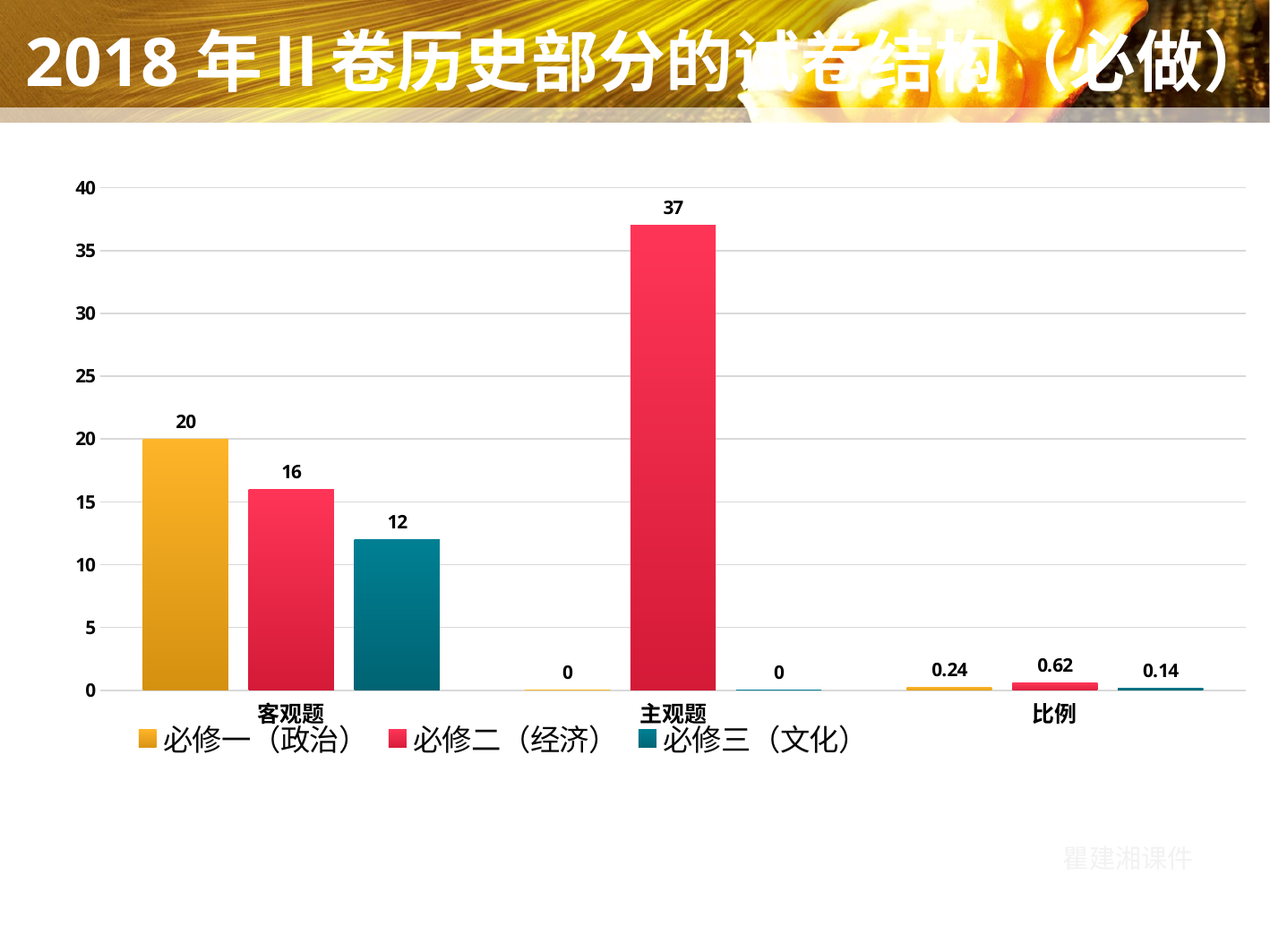
How many categories are shown on the x axis? 3 What is the value for 必修一（政治） in the 客观题 category? 20 How many series does the legend list? 3 What is the value for 必修三（文化） in the 比例 category? 0.14 What is the difference between the 必修一（政治） and 必修三（文化） values in the 客观题 category? 8 Which series has the lowest value in the 比例 category? 必修三（文化） What is the value for 必修二（经济） in the 主观题 category? 37 In the 比例 category, which is larger: 必修一（政治） or 必修二（经济）? 必修二（经济） What is the value for 必修一（政治） in the 主观题 category? 0 What kind of chart is shown on the slide? bar chart What is the total of the three series values in the 客观题 category? 48 Which series has the highest value in the 客观题 category? 必修一（政治）